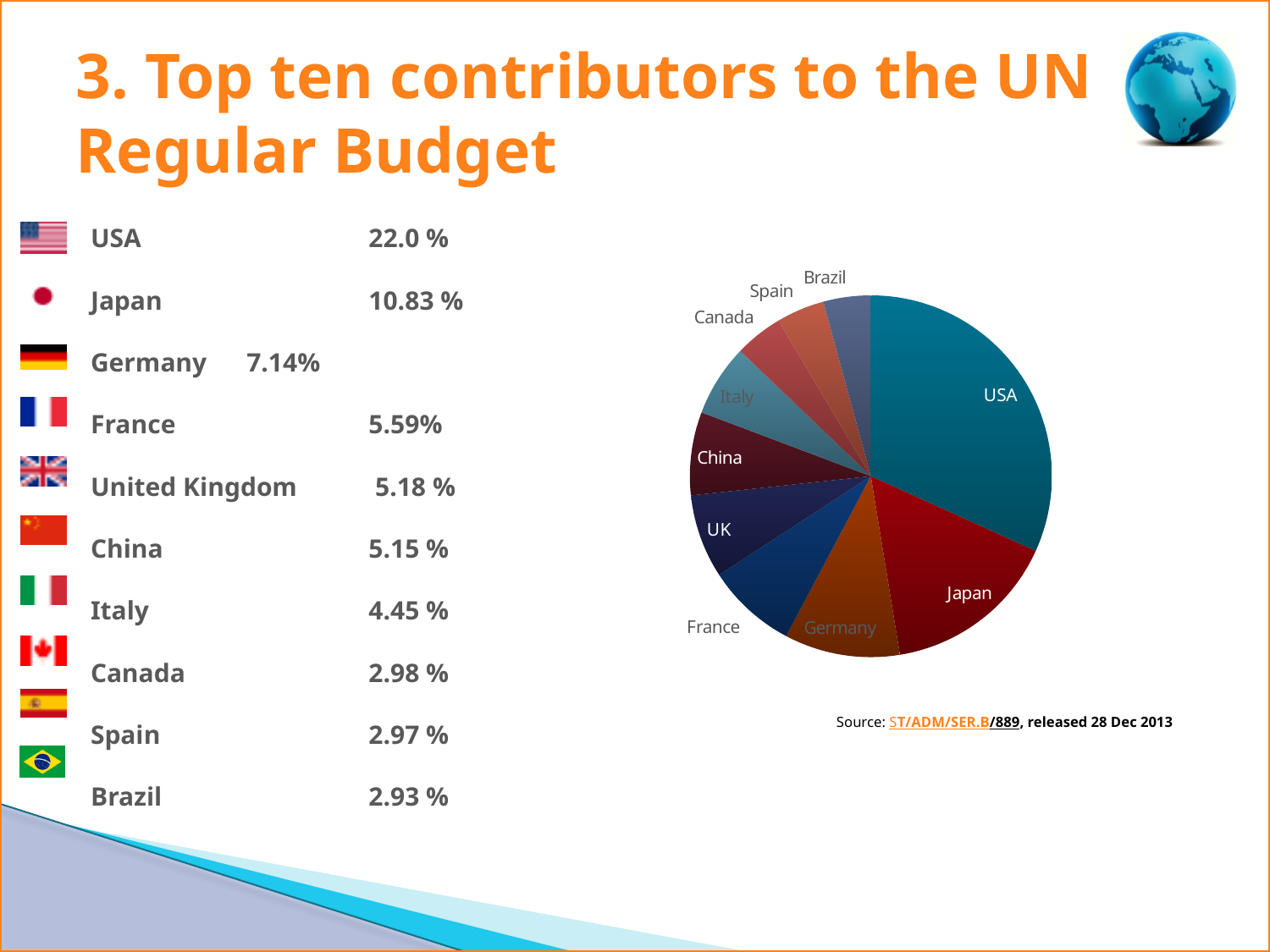
Which country has the largest slice in the pie chart? USA Which slice is larger in the pie chart, USA or Japan? USA What kind of chart is shown on the slide? pie chart Which slice is larger in the pie chart, Germany or Canada? Germany How many slices does the pie chart have? 10 What is the difference between Germany's and France's contributions shown on the slide? 1.55% What is Japan's contribution to the UN Regular Budget as shown on the slide? 10.83 % What is China's contribution to the UN Regular Budget as shown on the slide? 5.15 % What is the difference between the USA's and Japan's contributions shown on the slide? 11.17 % Which country has the smallest slice in the pie chart? Brazil What is the title of the slide containing the pie chart? 3. Top ten contributors to the UN Regular Budget What is the contribution of the USA to the UN Regular Budget as shown on the slide? 22.0 %